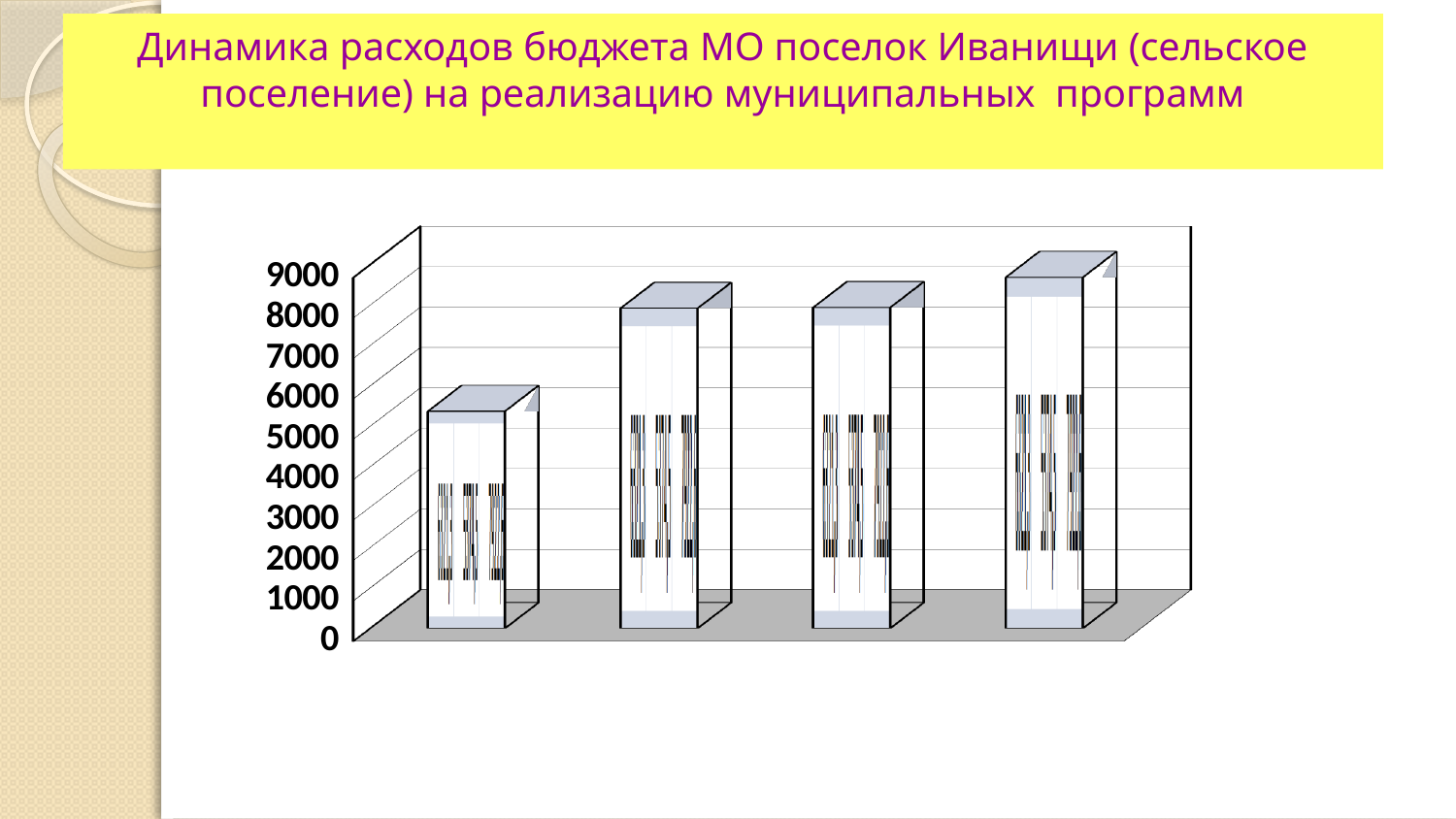
What kind of chart is shown on the slide? bar chart Is the value of the second bar from the left greater or less than 7000? greater Which is larger, the leftmost bar or the second bar from the left? the second bar from the left What is the highest value shown on the vertical axis? 9000 Is the value of the leftmost bar greater or less than 5000? greater Which bar is the highest in the chart? the rightmost bar How many bars are plotted in the chart? 4 Which is larger, the leftmost bar or the rightmost bar? the rightmost bar Is the value of the leftmost bar greater or less than 7000? less Do the bar values overall rise or fall from left to right? rise Which bar is the lowest in the chart? the leftmost bar